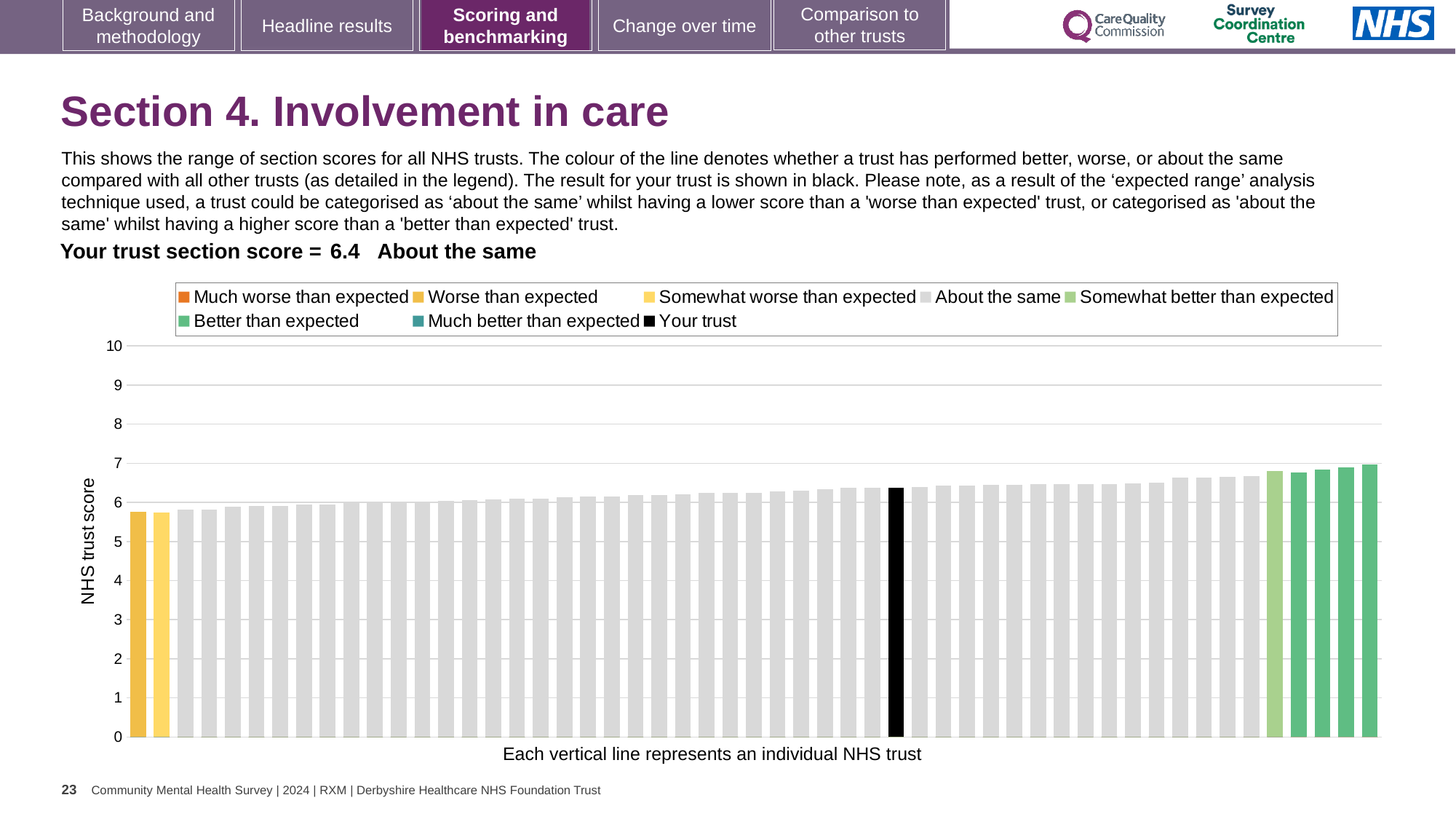
Is the value for your trust (the black bar) greater or less than 6? greater Is the value for your trust (the black bar) greater or less than 7? less How many bars at the right end of the chart are coloured green? 5 How many entries does the chart legend list? 8 What is the section score for your trust shown on the slide? 6.4 What is the label on the vertical axis of the chart? NHS trust score What colour is the bar representing your trust? black Do the bar values rise or fall from left to right along the x axis? rise Is the value of the rightmost bar greater or less than 6? greater What kind of chart is shown on the slide? bar chart Which performance category is your trust placed in for this section? About the same